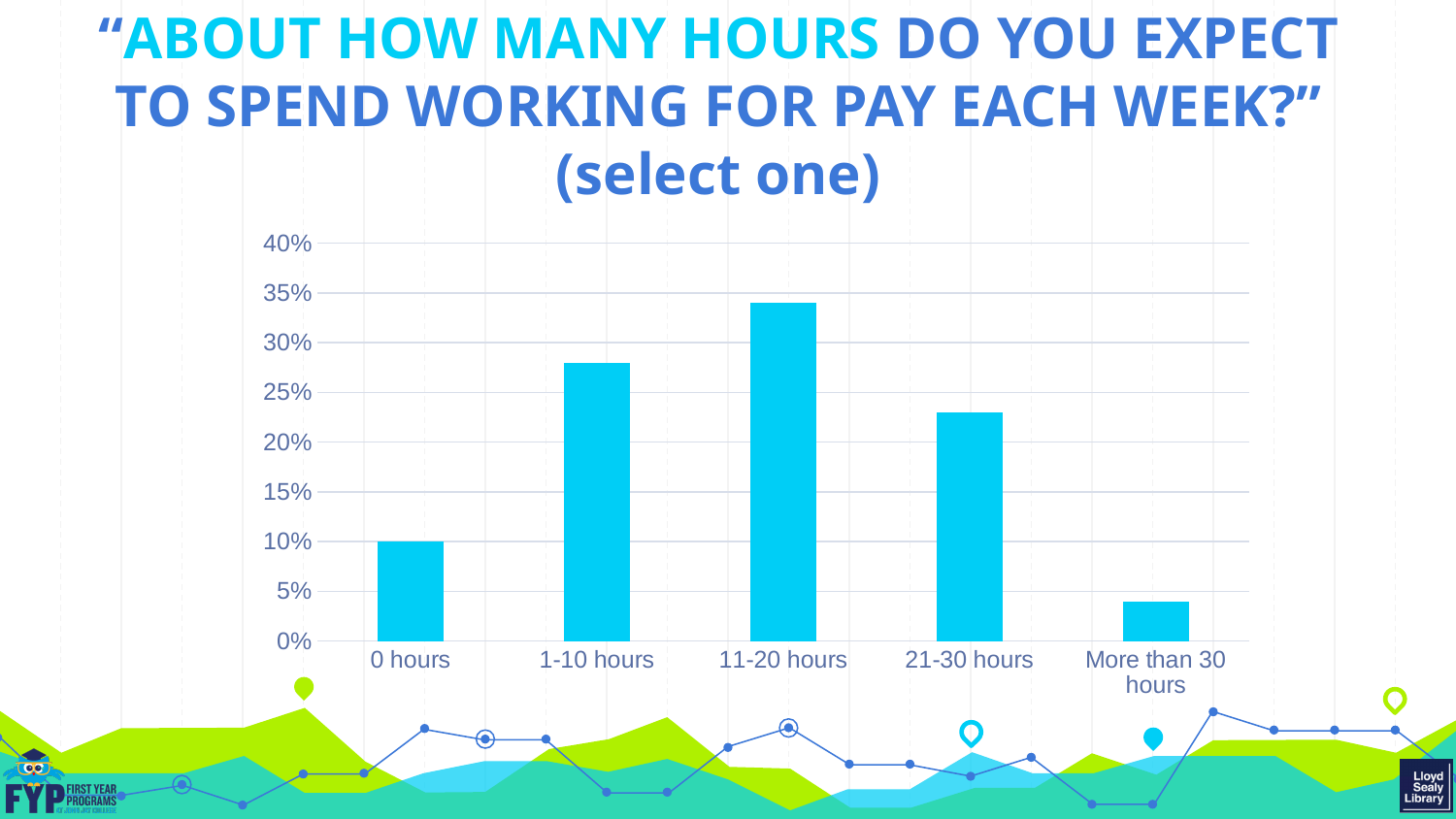
What is the value for 0 hours? 10% Is the value for 11-20 hours greater or less than 30%? greater How many categories are shown on the x axis of the chart? 5 Which category has the highest bar? 11-20 hours Is the value for 21-30 hours greater or less than 25%? less What is the highest value shown on the y axis? 40% Is the value for 1-10 hours greater or less than 25%? greater Which is larger, the value for 1-10 hours or the value for 21-30 hours? 1-10 hours What is the title of the chart? "About how many hours do you expect to spend working for pay each week?" (select one) What kind of chart is shown on the slide? bar chart Which category has the lowest bar? More than 30 hours